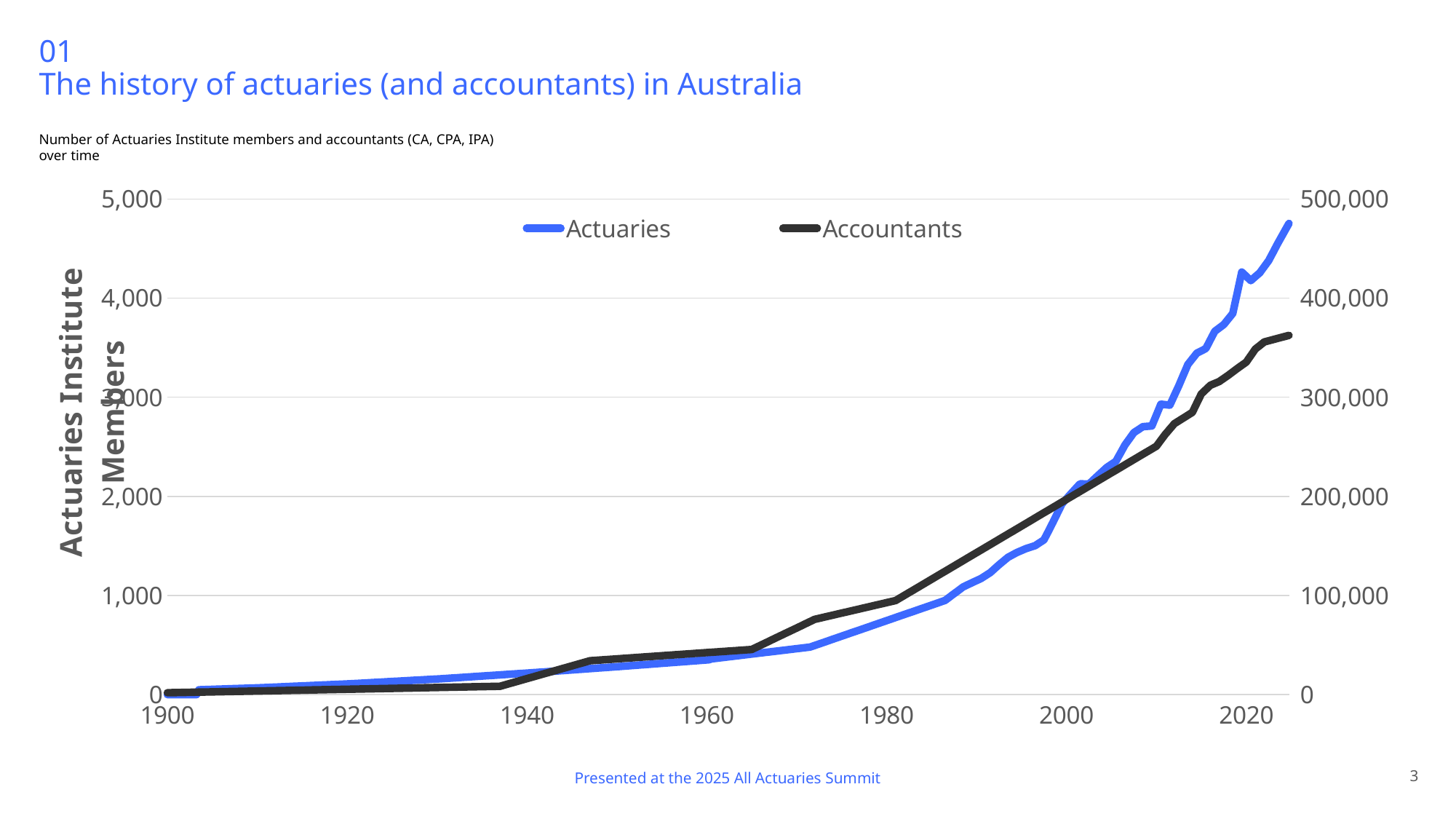
Which colour is used for the Actuaries line? blue Does the Actuaries line rise or fall from 1900 to 2020? rise How many series does the chart's legend list? 2 What are the two series named in the legend? Actuaries and Accountants Does the Accountants line rise or fall from 1960 to 2020? rise Is the value for Accountants in 2020 greater or less than 300,000? greater Is the value for Actuaries in 1980 greater or less than 1,000? less Is the value for Actuaries in 1960 greater or less than 1,000? less What kind of chart is shown on the slide? line chart